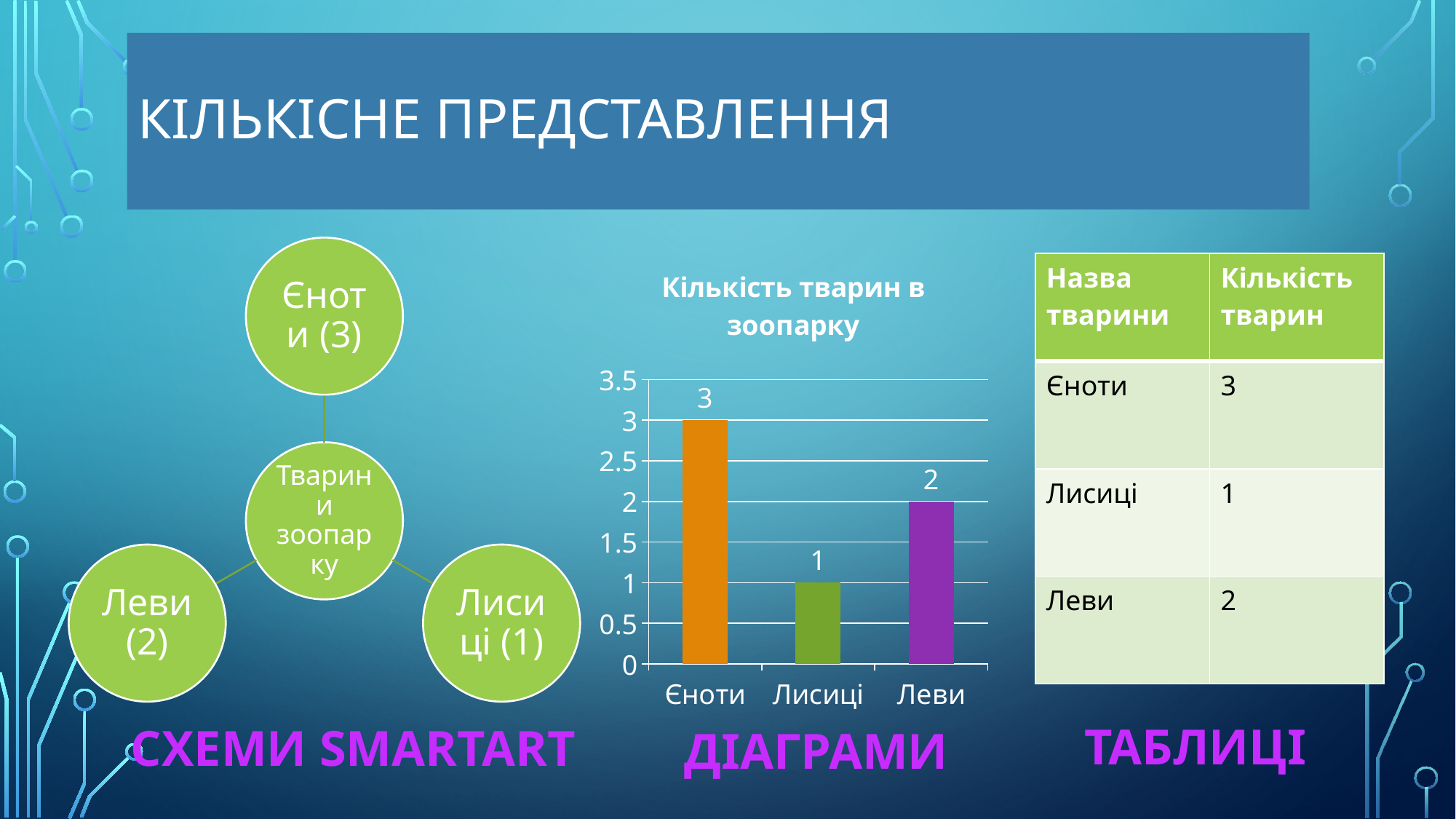
Is the value for Єноти greater or less than 2.5? greater Which is larger, the value for Леви or the value for Лисиці? Леви What is the difference between the values for Єноти and Лисиці? 2 How many categories are shown on the x axis of the chart? 3 What is the difference between the values for Леви and Лисиці? 1 What is the title of the chart? Кількість тварин в зоопарку What kind of chart is shown on the slide? bar chart Which category has the highest value in the chart? Єноти What is the value for Єноти in the chart? 3 What is the value for Леви in the chart? 2 What is the value for Лисиці in the chart? 1 Which category has the lowest value in the chart? Лисиці